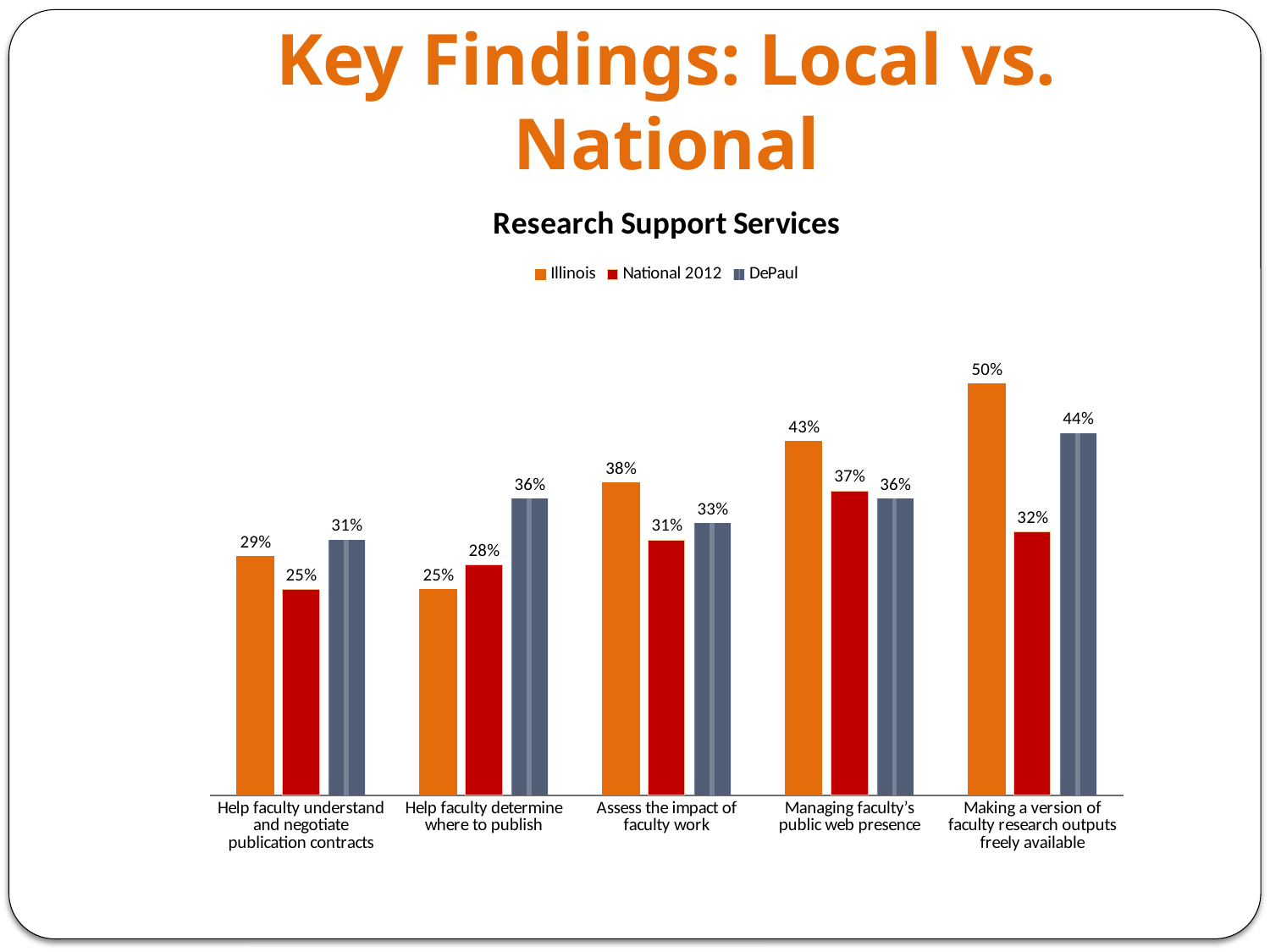
What is the DePaul value for 'Help faculty determine where to publish'? 36% For 'Help faculty determine where to publish', which is larger: the Illinois value or the DePaul value? DePaul What is the title of the chart? Research Support Services How many categories are shown on the x axis? 5 Which category has the lowest National 2012 value? Help faculty understand and negotiate publication contracts What is the National 2012 value for 'Assess the impact of faculty work'? 31% What is the difference between the Illinois and National 2012 values for 'Making a version of faculty research outputs freely available'? 18% What is the Illinois value for 'Making a version of faculty research outputs freely available'? 50% How many series does the legend list? 3 What kind of chart is shown on the slide? Bar chart Which category has the highest Illinois value? Making a version of faculty research outputs freely available